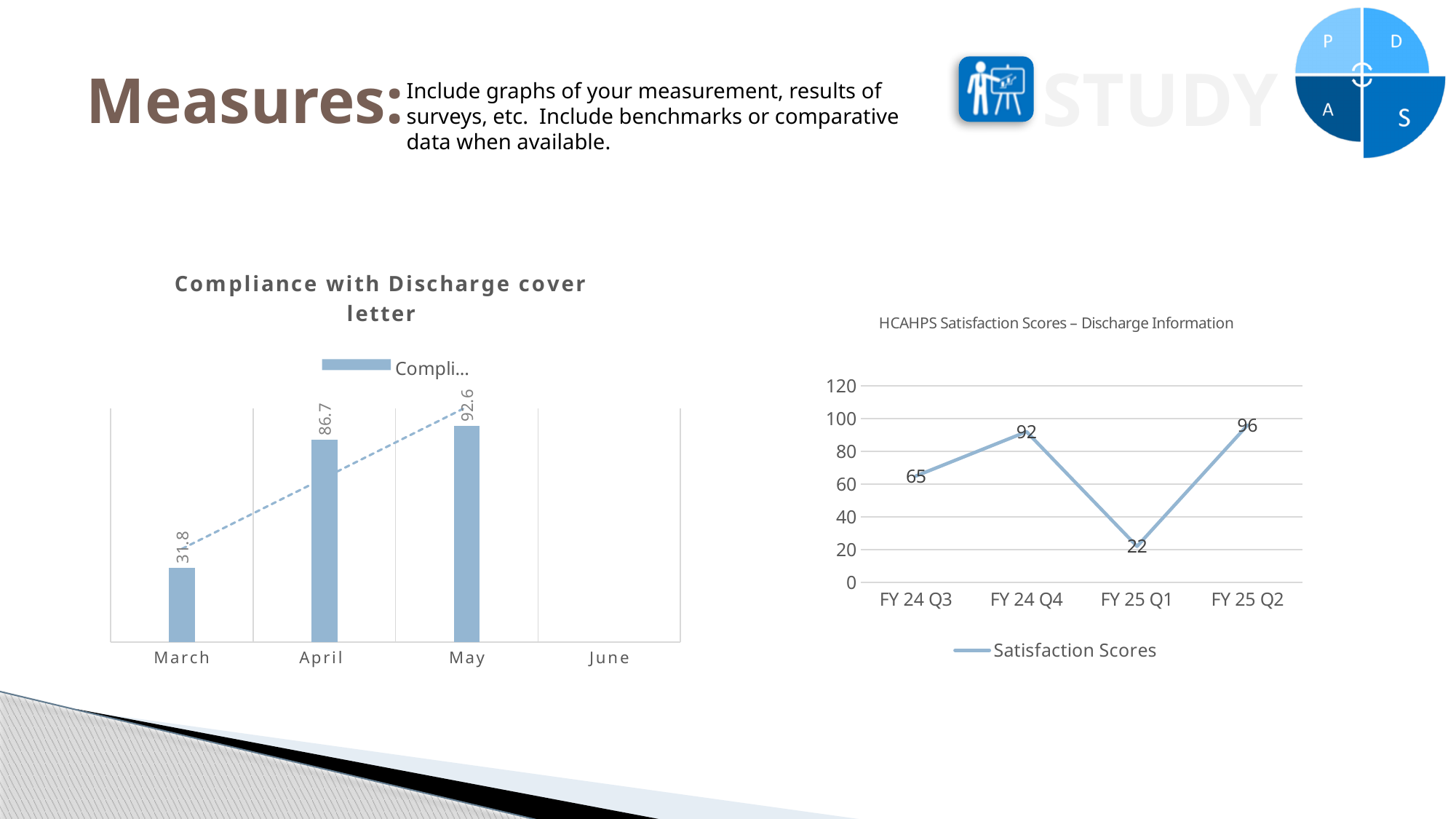
In the 'Compliance with Discharge cover letter' chart, do the values rise or fall from March to May? rise In the 'Compliance with Discharge cover letter' chart, what is the value for April? 86.7 In the 'Compliance with Discharge cover letter' chart, which month has the highest value? May In the 'Compliance with Discharge cover letter' chart, what is the value for March? 31.8 What is the legend entry in the 'HCAHPS Satisfaction Scores – Discharge Information' chart? Satisfaction Scores In the 'Compliance with Discharge cover letter' chart, how many month labels appear on the x axis? 4 In the 'Compliance with Discharge cover letter' chart, what is the difference between the May and March values? 60.8 In the 'HCAHPS Satisfaction Scores – Discharge Information' chart, which is larger, the FY 24 Q3 score or the FY 24 Q4 score? FY 24 Q4 In the 'HCAHPS Satisfaction Scores – Discharge Information' chart, which quarter has the highest score? FY 25 Q2 In the 'HCAHPS Satisfaction Scores – Discharge Information' chart, what is the difference between the FY 25 Q2 and FY 25 Q1 scores? 74 In the 'HCAHPS Satisfaction Scores – Discharge Information' chart, what is the value for FY 25 Q1? 22 What kind of chart is the 'Compliance with Discharge cover letter' chart? bar chart